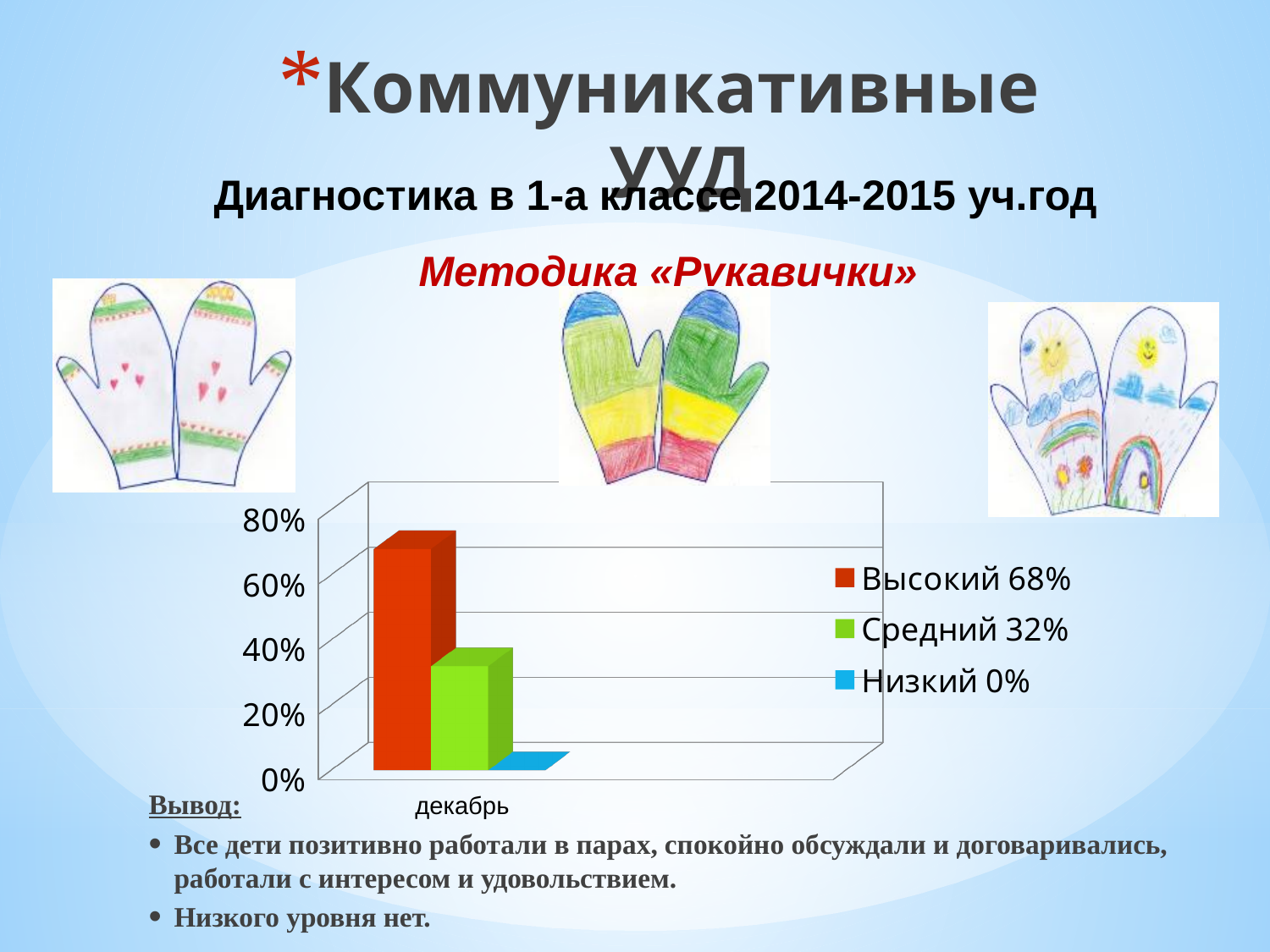
What is the difference between the values for «Высокий» and «Средний»? 36% What kind of chart is shown on the slide? bar chart What value does the legend give for the series «Низкий»? 0% Which series has the highest value in the chart? Высокий How many series does the legend list? 3 Is the value for «Средний» greater or less than 40%? less What value does the legend give for the series «Средний»? 32% What value does the legend give for the series «Высокий»? 68% Which is larger, the value for «Средний» or the value for «Низкий»? Средний Is the value for «Высокий» greater or less than 60%? greater Which series has the lowest value in the chart? Низкий What is the category label shown on the x axis of the chart? декабрь